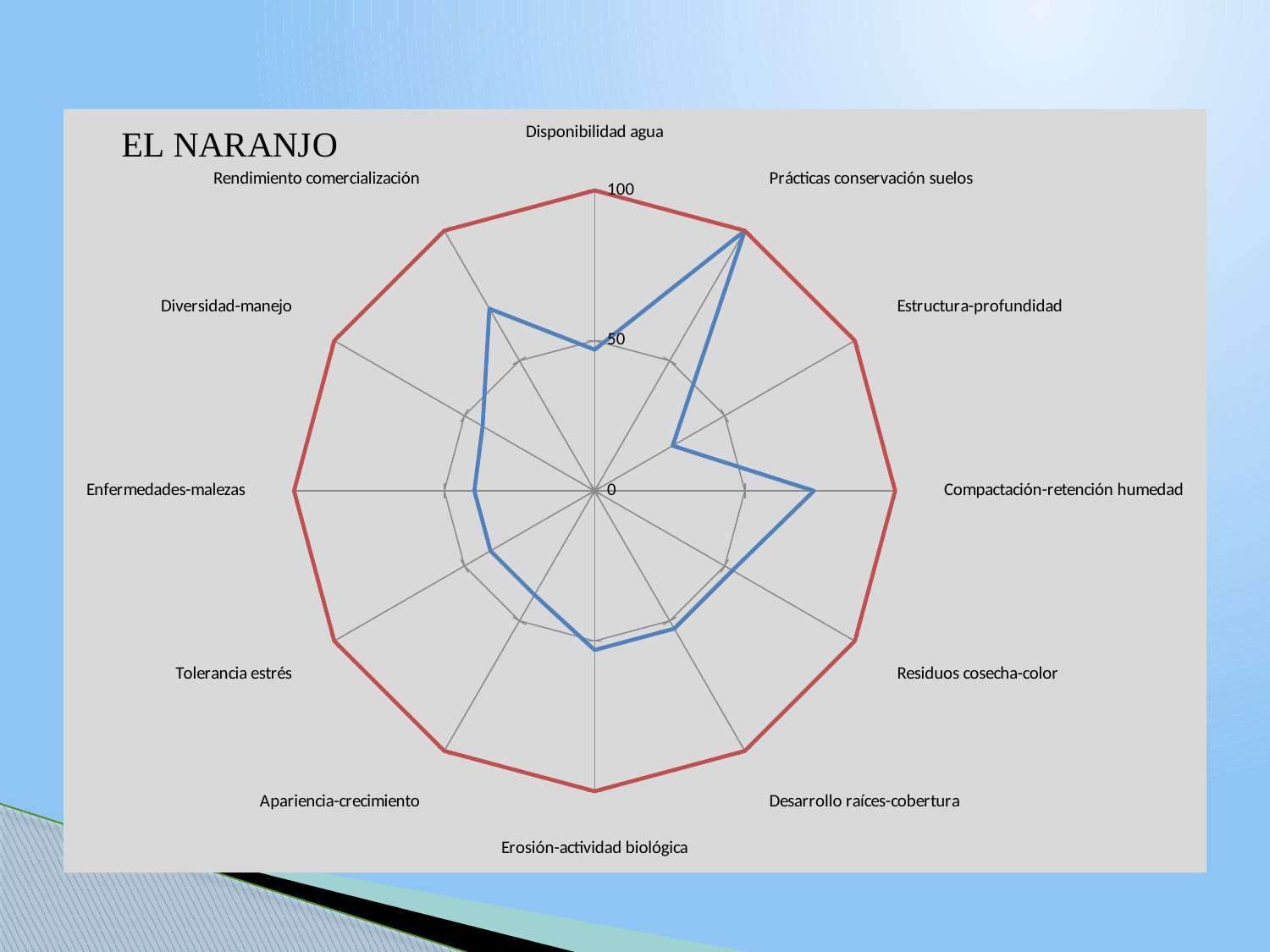
Is the blue line's value for Estructura-profundidad greater or less than 50? less What value does the red line reach on the Disponibilidad agua axis? 100 On which category does the blue line have its lowest value? Estructura-profundidad For the blue line, which is larger: the value for Prácticas conservación suelos or the value for Enfermedades-malezas? Prácticas conservación suelos How many categories (axes) does the radar chart have? 12 What is the maximum value shown on the chart's axis scale? 100 For the blue line, which is larger: the value for Compactación-retención humedad or the value for Estructura-profundidad? Compactación-retención humedad Is the blue line's value for Compactación-retención humedad greater or less than 50? greater What type of chart is shown on the slide? Radar chart What is the title shown on the chart? EL NARANJO On which category does the blue line reach its highest value? Prácticas conservación suelos Is the blue line's value for Prácticas conservación suelos greater or less than 50? greater